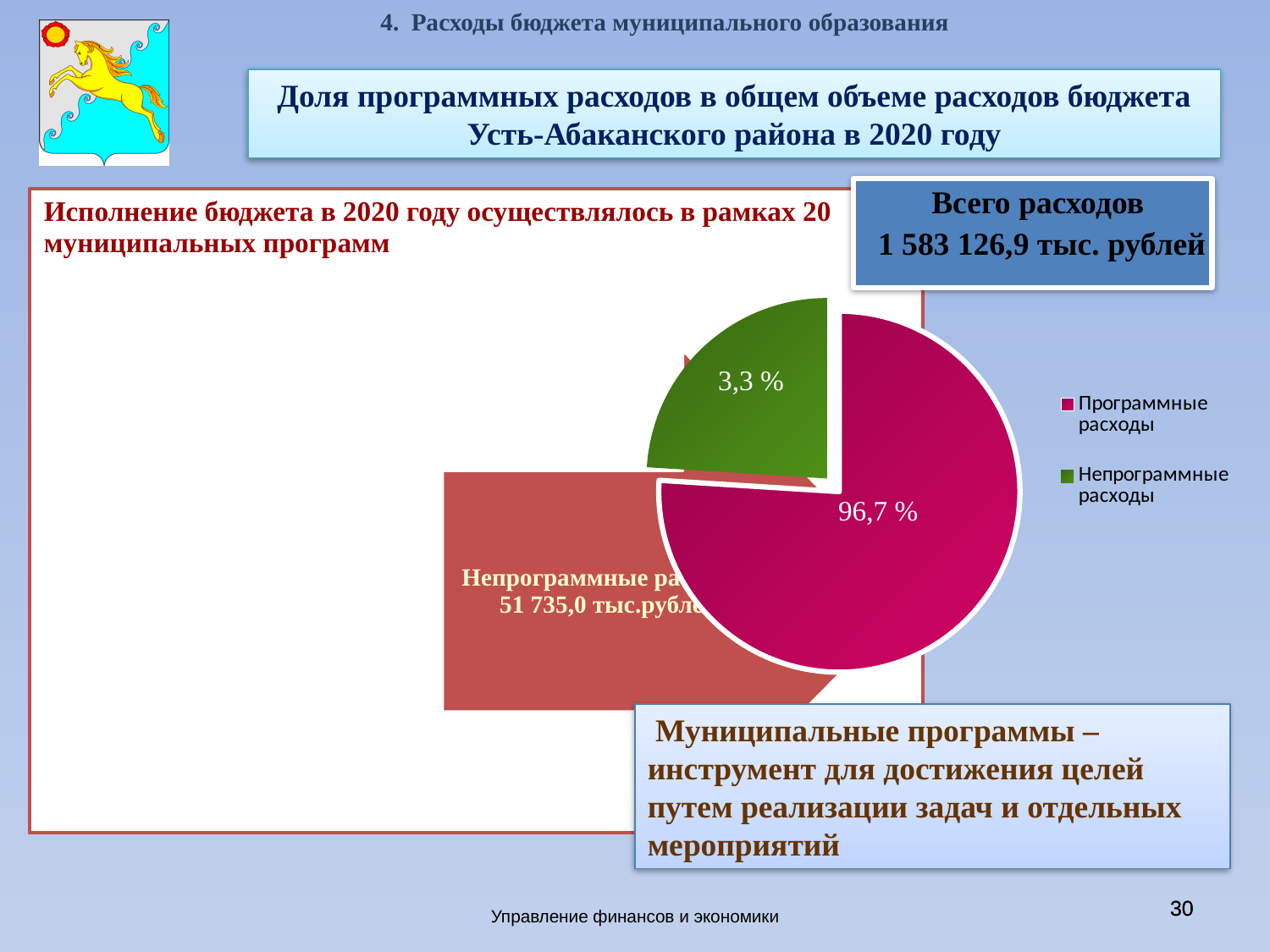
How many slices does the pie chart have? 2 Which slice of the pie chart is the largest? Программные расходы Is the share for Непрограммные расходы greater or less than 10%? less What share of the pie is labelled for Непрограммные расходы? 3,3 % Which slice of the pie chart is the smallest? Непрограммные расходы What colour is the Программные расходы slice in the pie chart? magenta (crimson) What is the difference in percentage points between the Программные расходы slice and the Непрограммные расходы slice? 93,4 What colour is the Непрограммные расходы slice in the pie chart? green What kind of chart is shown on the slide? pie chart Which is larger in the pie chart: Программные расходы or Непрограммные расходы? Программные расходы What share of the pie is labelled for Программные расходы? 96,7 % How many entries does the legend of the pie chart list? 2